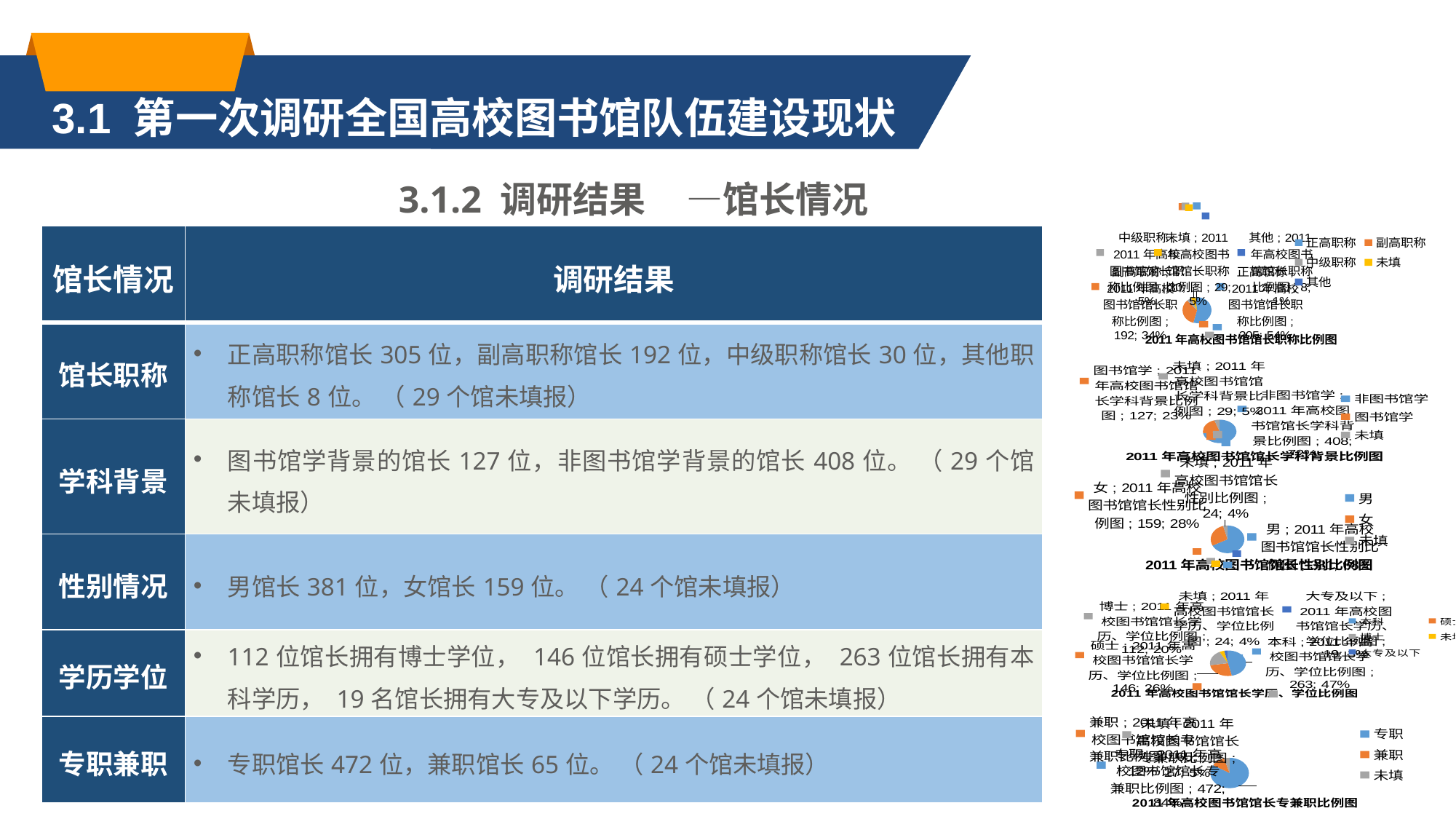
In the chart titled 2011年高校图书馆馆长学历、学位比例图, what share of the pie is labelled for 本科? 47% In the chart titled 2011年高校图书馆馆长学科背景比例图, which category has the largest slice? 非图书馆学 What kind of charts are shown on the right side of the slide? Pie charts In the chart titled 2011年高校图书馆馆长学历、学位比例图, which is larger, the value for 本科 or the value for 硕士? 本科 In the chart titled 2011年高校图书馆馆长专兼职比例图, which category has the largest slice? 专职 In the chart titled 2011年高校图书馆馆长学历、学位比例图, what value is labelled for 硕士? 146 In the chart titled 2011年高校图书馆馆长学历、学位比例图, what is the difference between the value for 本科 (263) and the value for 硕士 (146)? 117 In the chart titled 2011年高校图书馆馆长性别比例图, how many entries does the legend list? 3 In the chart titled 2011年高校图书馆馆长性别比例图, what share of the pie is labelled for 女? 28% In the chart titled 2011年高校图书馆馆长性别比例图, which category has the largest slice? 男 In the chart titled 2011年高校图书馆馆长学科背景比例图, what share of the pie is labelled for 图书馆学? 23% How many pie charts are shown on the slide? 5